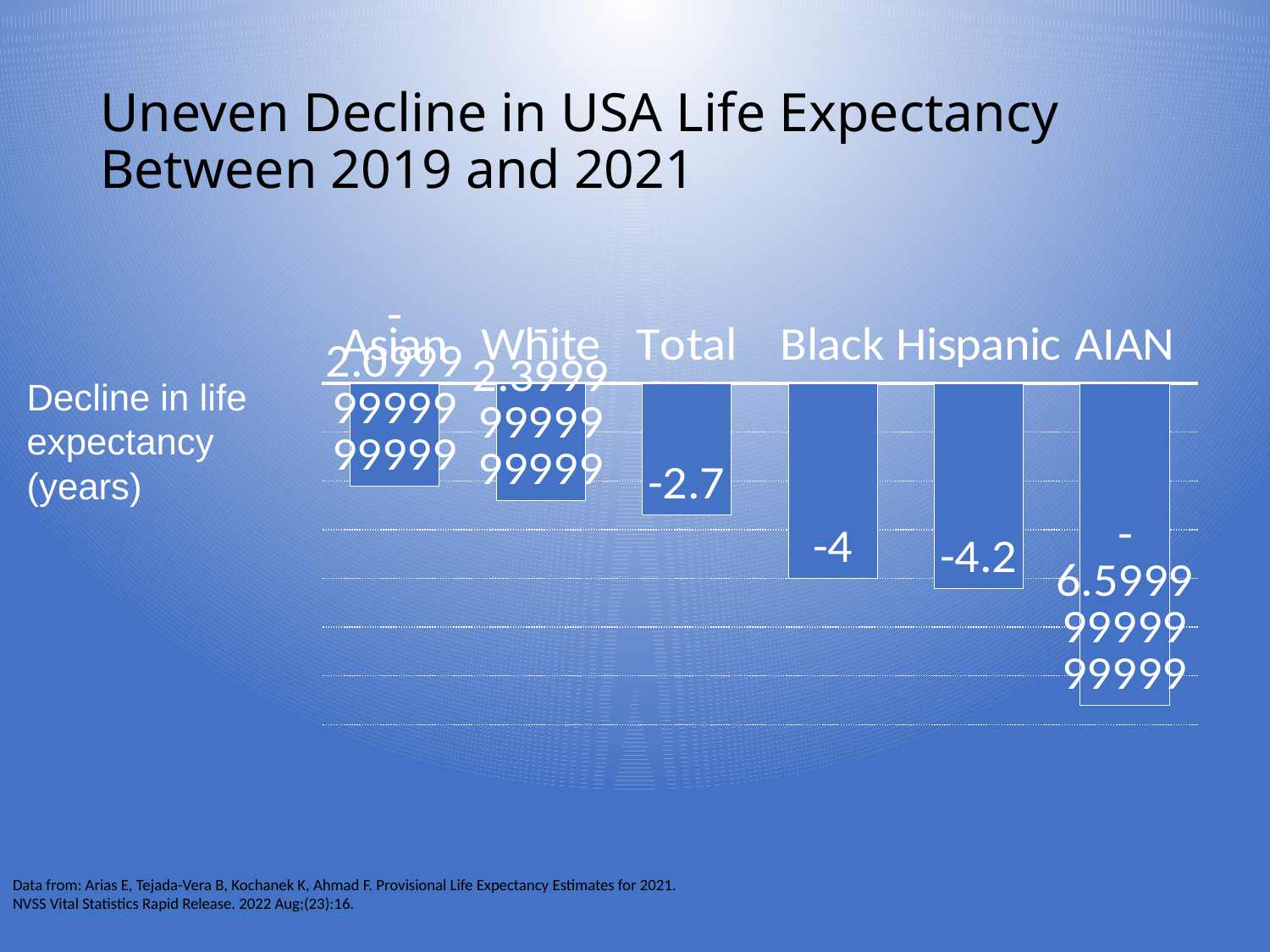
Which category shows the largest decline in life expectancy? AIAN Do the values rise or fall moving from Asian to AIAN along the x axis? fall Which category shows the smallest decline in life expectancy? Asian How many categories are plotted in the chart? 6 Which has the larger decline in life expectancy, Black or Hispanic? Hispanic What is the difference between the values for Black and Hispanic? 0.2 What is the difference between the values for Total and Black? 1.3 What kind of chart is shown on the slide? bar chart What is the value for Black in the chart? -4 What is the value for Total in the chart? -2.7 What is the value for Hispanic in the chart? -4.2 What is the title of the slide containing the chart? Uneven Decline in USA Life Expectancy Between 2019 and 2021